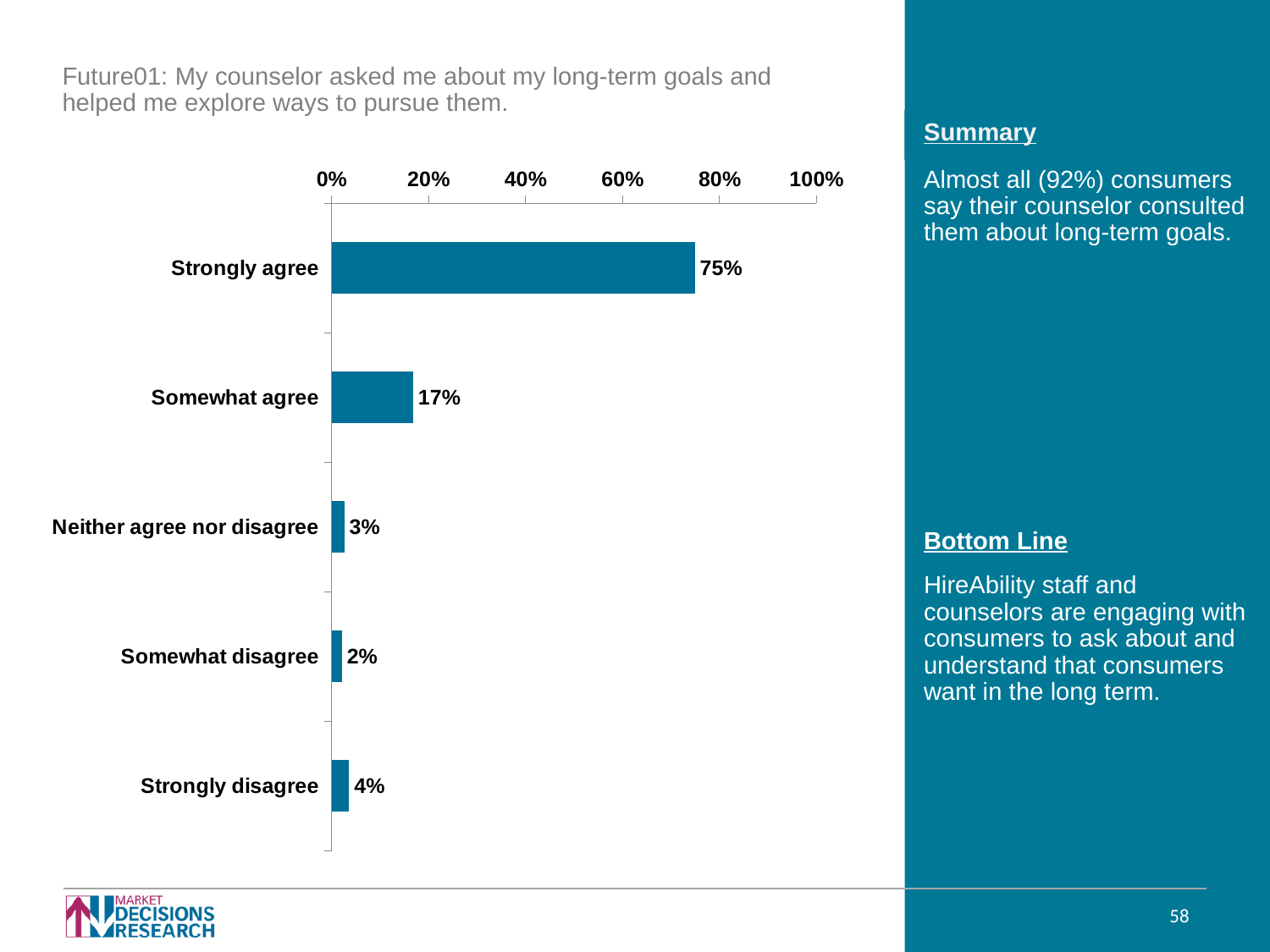
What percentage of respondents selected 'Neither agree nor disagree'? 3% What percentage of respondents selected 'Strongly agree'? 75% Is the value for 'Strongly agree' greater or less than 60%? greater How many response categories are shown in the chart? 5 What is the combined percentage of 'Strongly agree' and 'Somewhat agree'? 92% What is the difference in percentage points between 'Strongly agree' and 'Somewhat agree'? 58 Which is larger, the value for 'Strongly disagree' or the value for 'Neither agree nor disagree'? Strongly disagree What percentage of respondents selected 'Strongly disagree'? 4% What type of chart is shown on the slide? Bar chart Which response category has the lowest percentage? Somewhat disagree What percentage of respondents selected 'Somewhat agree'? 17% Which response category has the highest percentage? Strongly agree